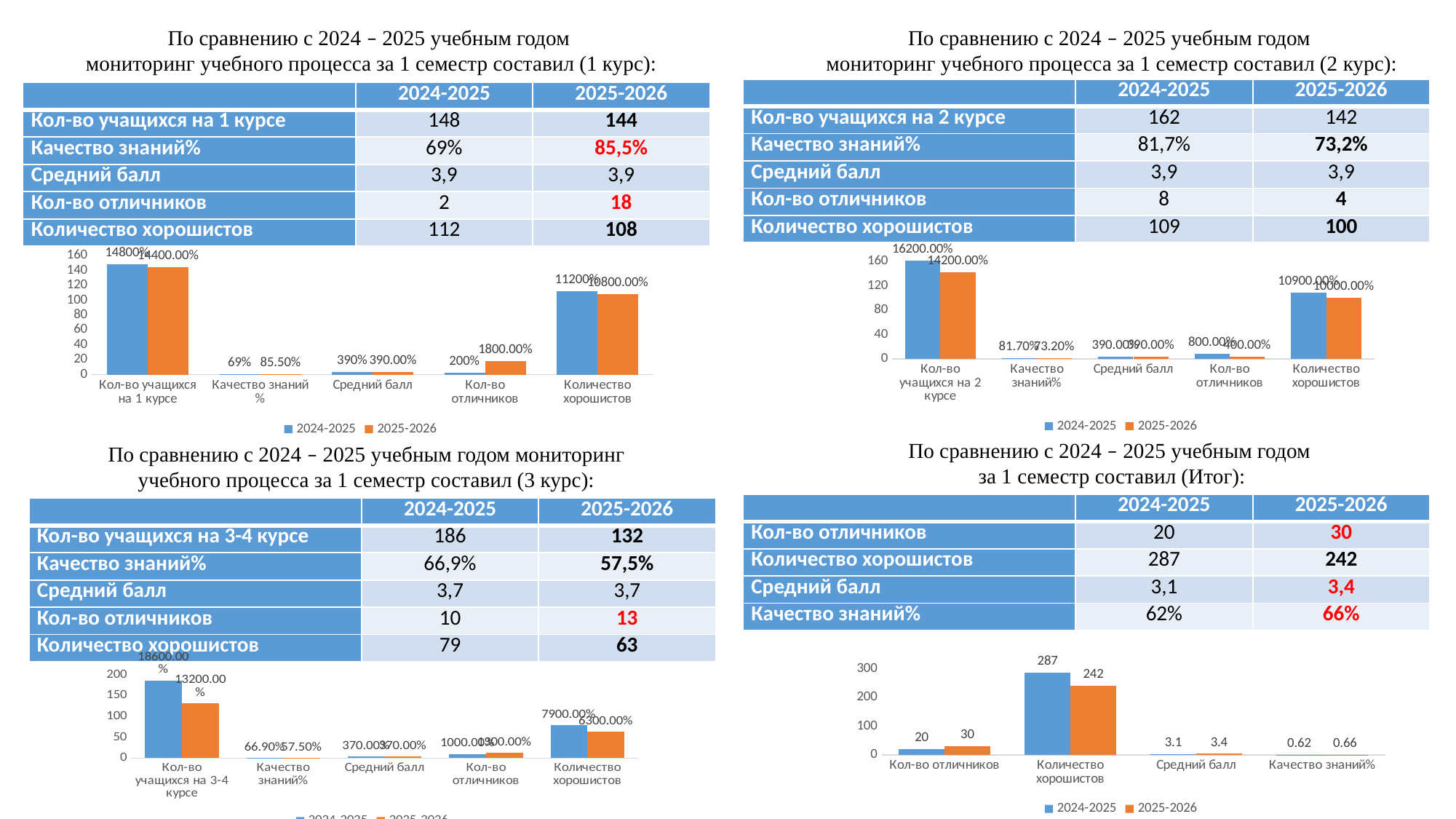
How many categories are shown on the x axis of the bottom-right chart (Итог)? 4 In the bottom-right chart (Итог), what is the value for Кол-во отличников in the 2025-2026 series? 30 In the bottom-right chart (Итог), what is the value for Количество хорошистов in the 2024-2025 series? 287 In the top-left chart (1 курс), is the 2024-2025 value for Кол-во учащихся на 1 курсе greater or less than 140? greater In the bottom-right chart (Итог), which category has the highest value in the 2024-2025 series? Количество хорошистов In the bottom-right chart (Итог), which is larger for Кол-во отличников: the 2024-2025 value or the 2025-2026 value? 2025-2026 How many series does the legend of the bottom-right chart (Итог) list? 2 What kind of chart is the bottom-right chart (Итог)? Bar chart In the bottom-left chart (3 курс), is the 2025-2026 value for Количество хорошистов greater or less than 50? greater In the top-right chart (2 курс), which category has the highest value in the 2024-2025 series? Кол-во учащихся на 2 курсе In the bottom-right chart (Итог), what is the difference between the 2024-2025 and 2025-2026 values for Количество хорошистов? 45 How many categories are shown on the x axis of the top-left chart (1 курс)? 5